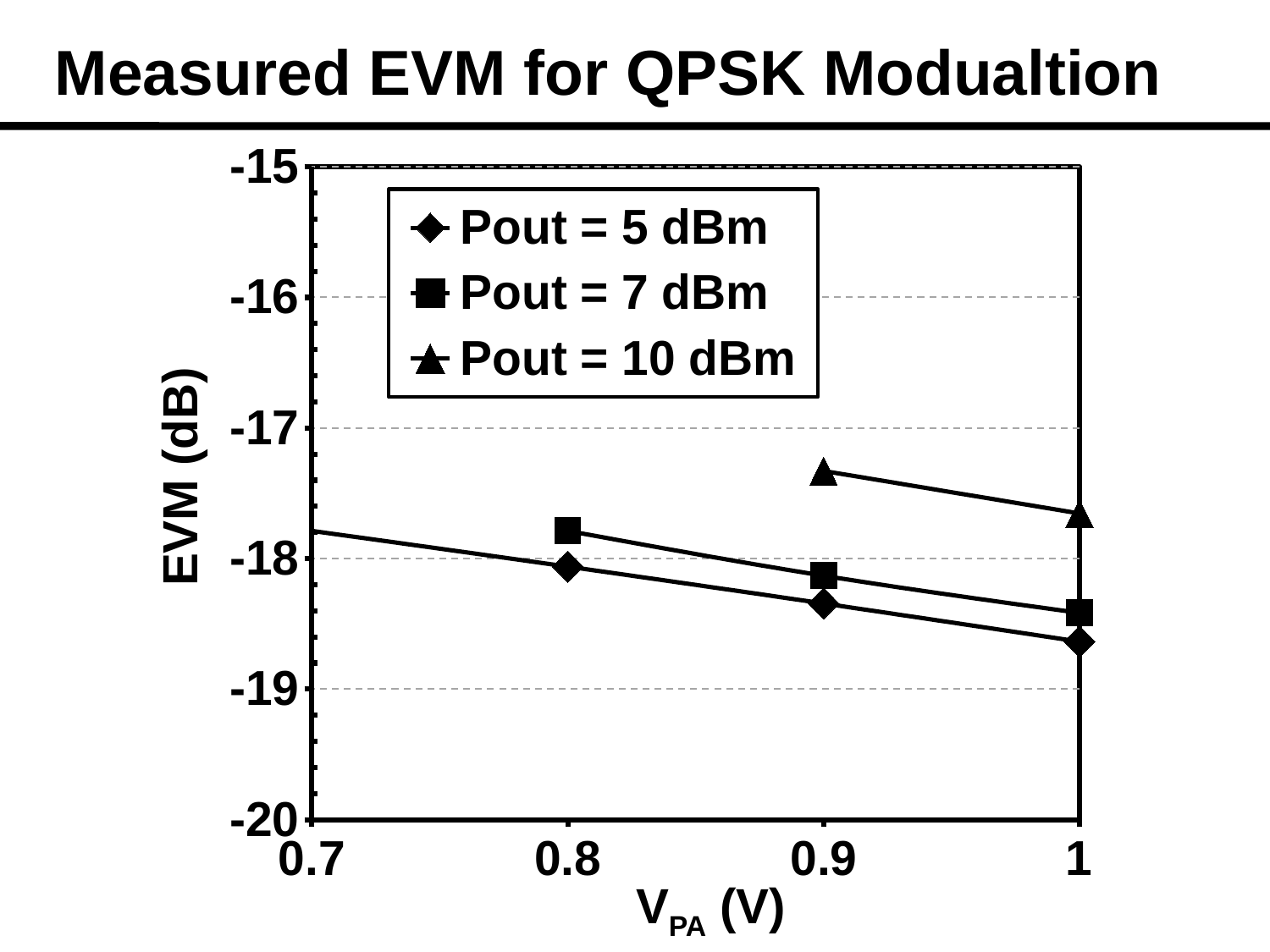
Is the EVM for Pout = 5 dBm at V_PA = 1 V greater or less than -18? less How many series does the legend list? 3 Is the EVM for Pout = 7 dBm at V_PA = 0.8 V greater or less than -18? greater At V_PA = 0.9 V, which is higher: the EVM for Pout = 7 dBm or for Pout = 5 dBm? Pout = 7 dBm Does the EVM for Pout = 5 dBm rise or fall as V_PA increases? fall What kind of chart is shown on the slide? line chart What is the label of the y axis? EVM (dB) Which series has the highest EVM at V_PA = 1 V? Pout = 10 dBm Which series has the lowest EVM at V_PA = 0.9 V? Pout = 5 dBm What is the title of the chart? Measured EVM for QPSK Modualtion Is the EVM for Pout = 10 dBm at V_PA = 0.9 V greater or less than -17? less